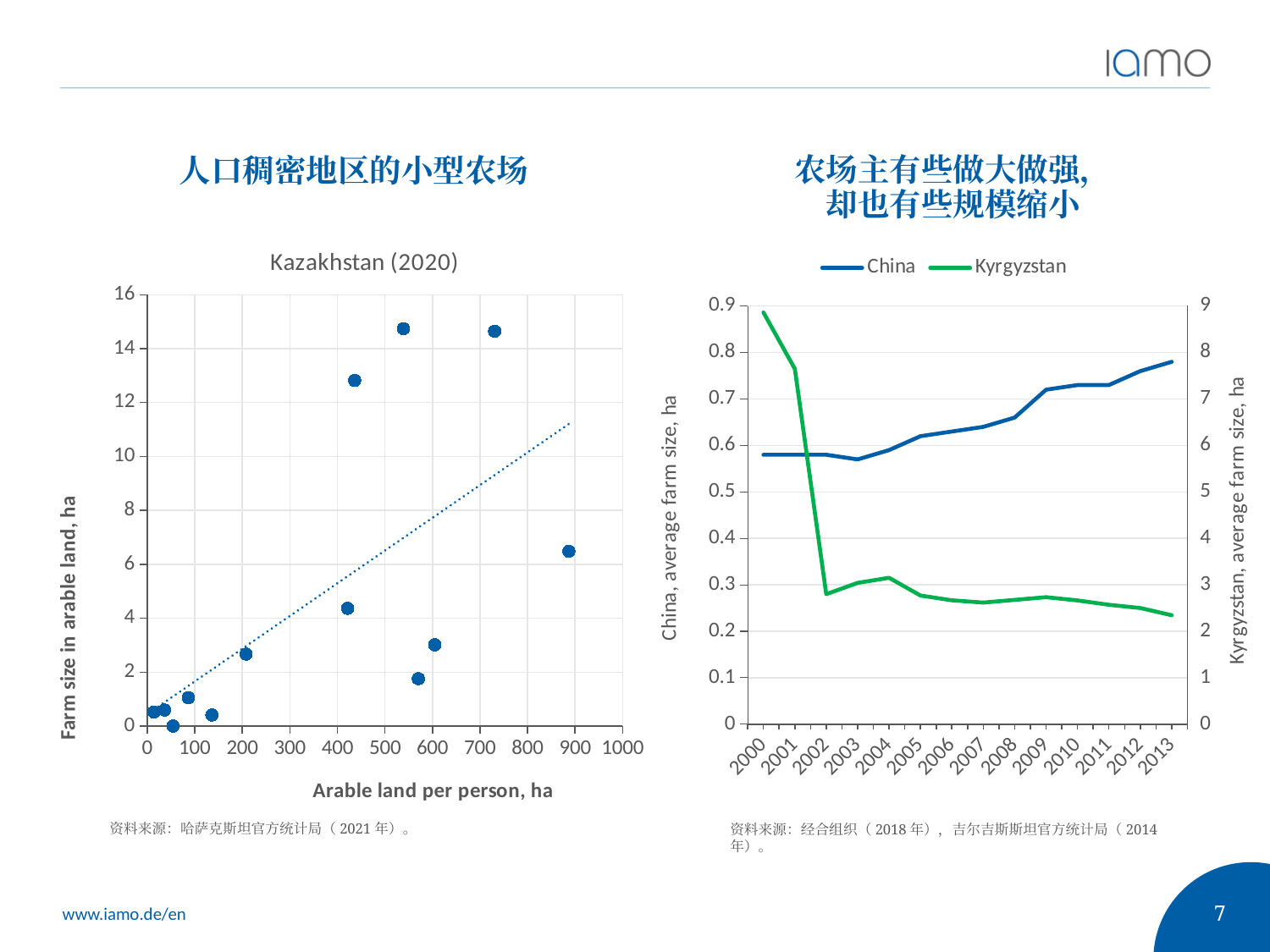
In the right chart, does the China series rise or fall from 2000 to 2013? rise In the right chart, is the value for China in 2013 greater or less than 0.7? greater In the right chart, is the value for Kyrgyzstan in 2000 greater or less than 8? greater What is the x-axis label of the left chart? Arable land per person, ha In the right chart, how many years are shown on the x axis? 14 How many series does the legend of the right chart list? 2 In the right chart, which year has the highest value for Kyrgyzstan? 2000 In the right chart, does the Kyrgyzstan series rise or fall from 2000 to 2013? fall What kind of chart is the right chart showing China and Kyrgyzstan? line chart What kind of chart is the left chart titled "Kazakhstan (2020)"? scatter chart What is the title of the left chart? Kazakhstan (2020) In the right chart, is the value for Kyrgyzstan in 2013 greater or less than 3? less